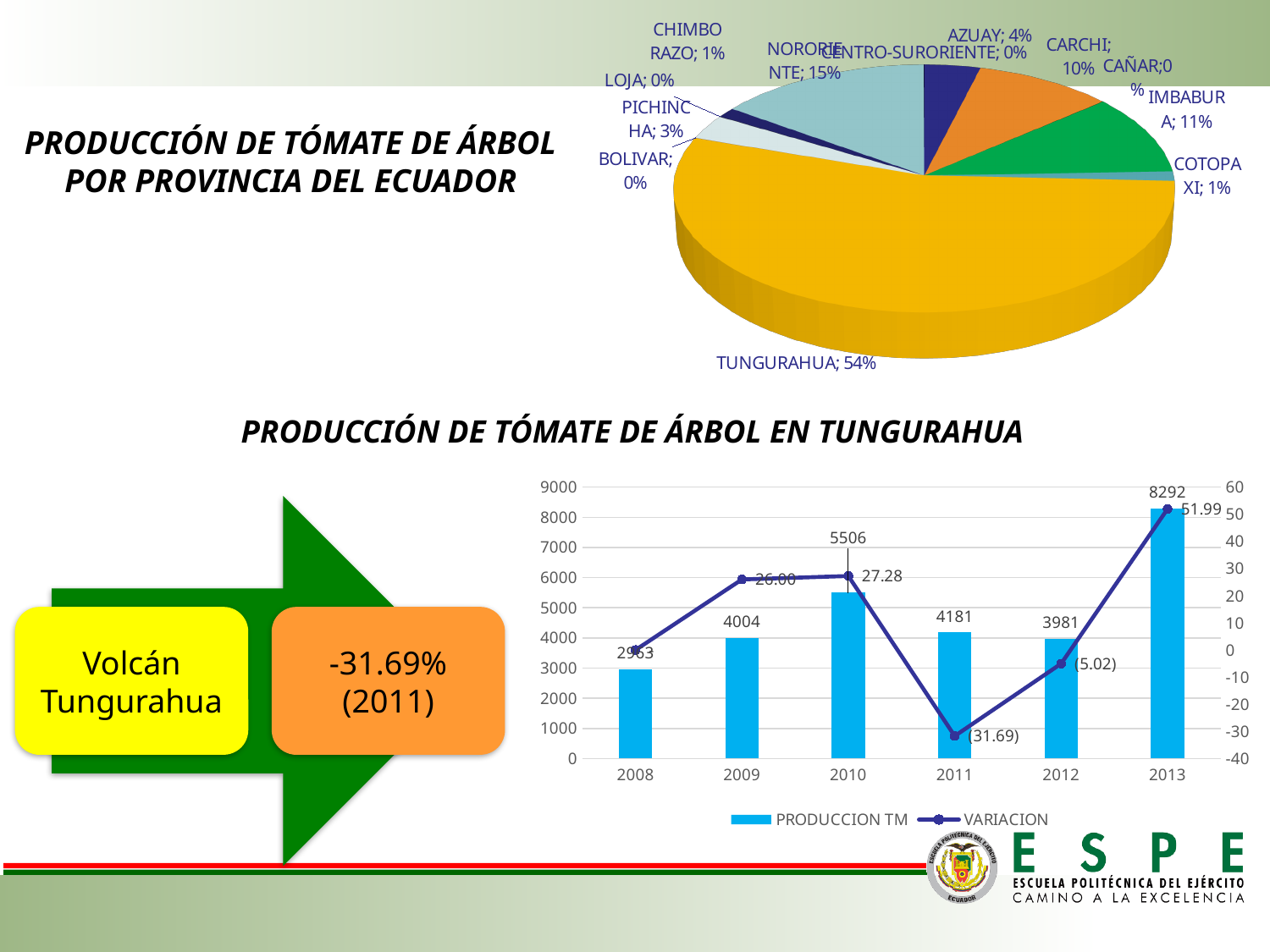
In the pie chart 'PRODUCCIÓN DE TÓMATE DE ÁRBOL POR PROVINCIA DEL ECUADOR', which is larger, the share for IMBABURA or the share for CARCHI? IMBABURA In the chart 'PRODUCCIÓN DE TÓMATE DE ÁRBOL EN TUNGURAHUA', what is the difference in PRODUCCION TM between 2013 and 2012? 4311 In the chart 'PRODUCCIÓN DE TÓMATE DE ÁRBOL EN TUNGURAHUA', how many years are shown on the x axis? 6 In the chart 'PRODUCCIÓN DE TÓMATE DE ÁRBOL EN TUNGURAHUA', which year has the lowest PRODUCCION TM? 2008 In the pie chart 'PRODUCCIÓN DE TÓMATE DE ÁRBOL POR PROVINCIA DEL ECUADOR', what share does TUNGURAHUA have? 54% In the chart 'PRODUCCIÓN DE TÓMATE DE ÁRBOL EN TUNGURAHUA', how many series does the legend list? 2 In the chart 'PRODUCCIÓN DE TÓMATE DE ÁRBOL EN TUNGURAHUA', what is the PRODUCCION TM value for 2013? 8292 In the pie chart 'PRODUCCIÓN DE TÓMATE DE ÁRBOL POR PROVINCIA DEL ECUADOR', what is the share for AZUAY? 4% In the pie chart 'PRODUCCIÓN DE TÓMATE DE ÁRBOL POR PROVINCIA DEL ECUADOR', which province has the largest share? TUNGURAHUA In the chart 'PRODUCCIÓN DE TÓMATE DE ÁRBOL EN TUNGURAHUA', what is the PRODUCCION TM value for 2008? 2963 In the chart 'PRODUCCIÓN DE TÓMATE DE ÁRBOL EN TUNGURAHUA', what is the VARIACION value for 2011? (31.69) In the pie chart 'PRODUCCIÓN DE TÓMATE DE ÁRBOL POR PROVINCIA DEL ECUADOR', what share does NORORIENTE have? 15%